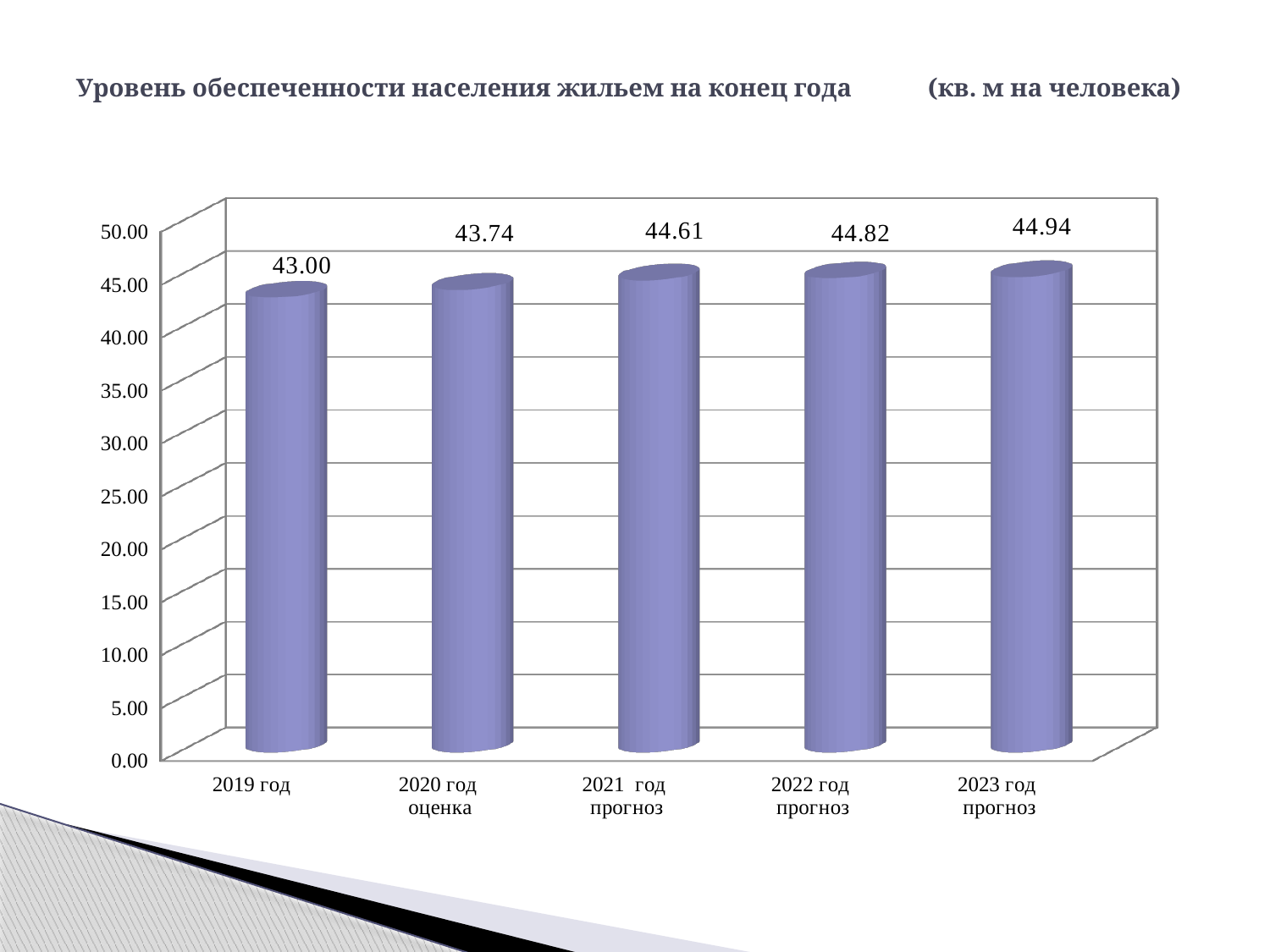
How many categories are shown on the x axis? 5 What is the value for 2023 год прогноз? 44.94 What is the value for 2021 год прогноз? 44.61 What is the difference between the values for 2021 год прогноз and 2020 год оценка? 0.87 Which category has the lowest value? 2019 год What is the value for 2020 год оценка? 43.74 Is the value for 2019 год greater or less than 40.00? greater Which is larger, the value for 2022 год прогноз or the value for 2023 год прогноз? 2023 год прогноз What kind of chart is shown on the slide? bar chart Which category has the highest value? 2023 год прогноз What is the value for 2019 год? 43.00 What is the difference between the values for 2023 год прогноз and 2019 год? 1.94